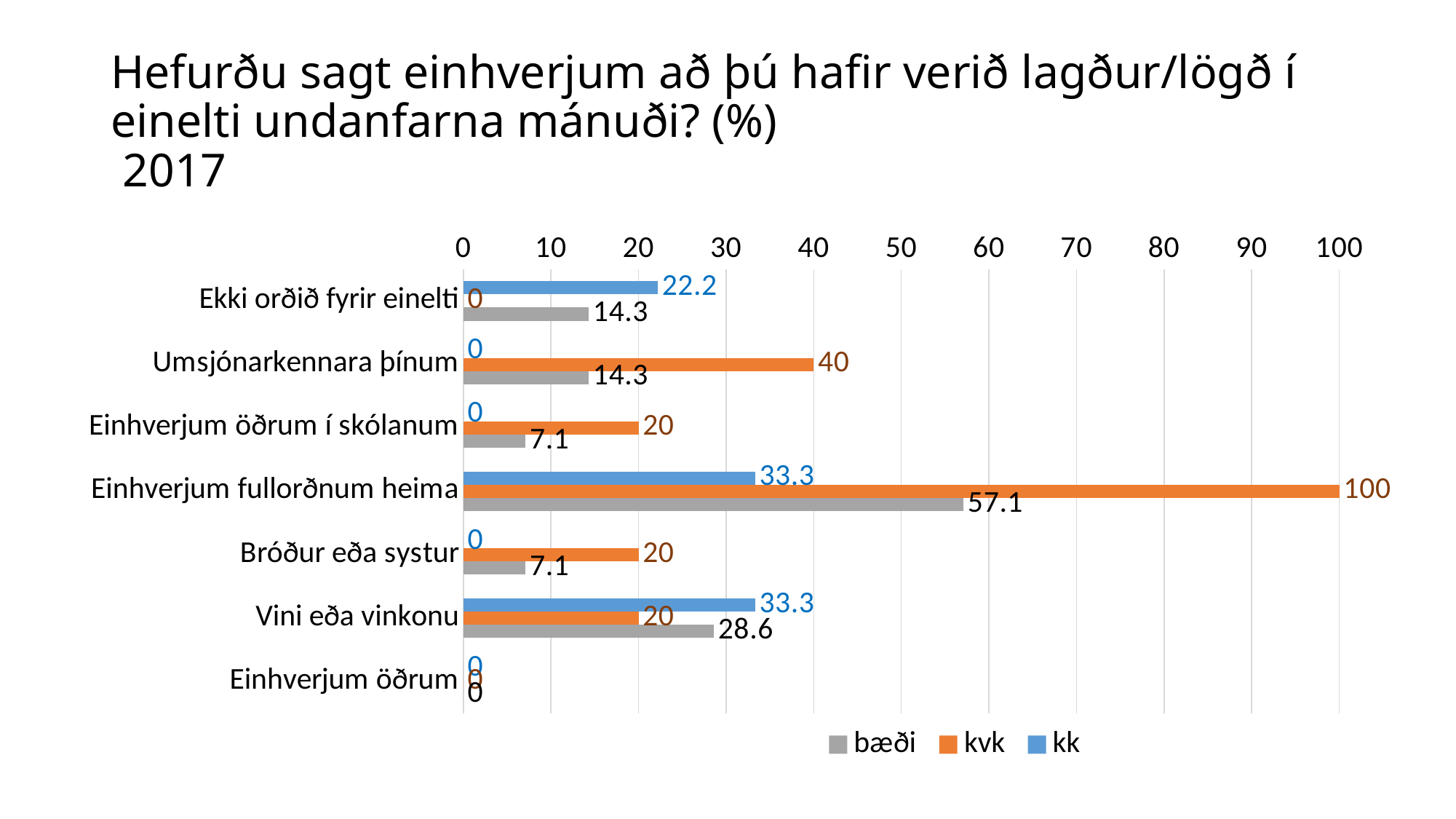
Which series is shown in orange in the legend? kvk What is the difference between the kvk and bæði values for Einhverjum fullorðnum heima? 42.9 What kind of chart is shown on the slide? Bar chart What is the bæði value for Vini eða vinkonu? 28.6 What is the kvk value for Einhverjum fullorðnum heima? 100 What is the kvk value for Umsjónarkennara þínum? 40 Which is larger for Vini eða vinkonu, the kk value or the kvk value? kk How many series does the legend list? 3 What is the kk value for Ekki orðið fyrir einelti? 22.2 What is the bæði value for Einhverjum öðrum? 0 Which category has the highest bæði value? Einhverjum fullorðnum heima How many categories are shown on the chart? 7